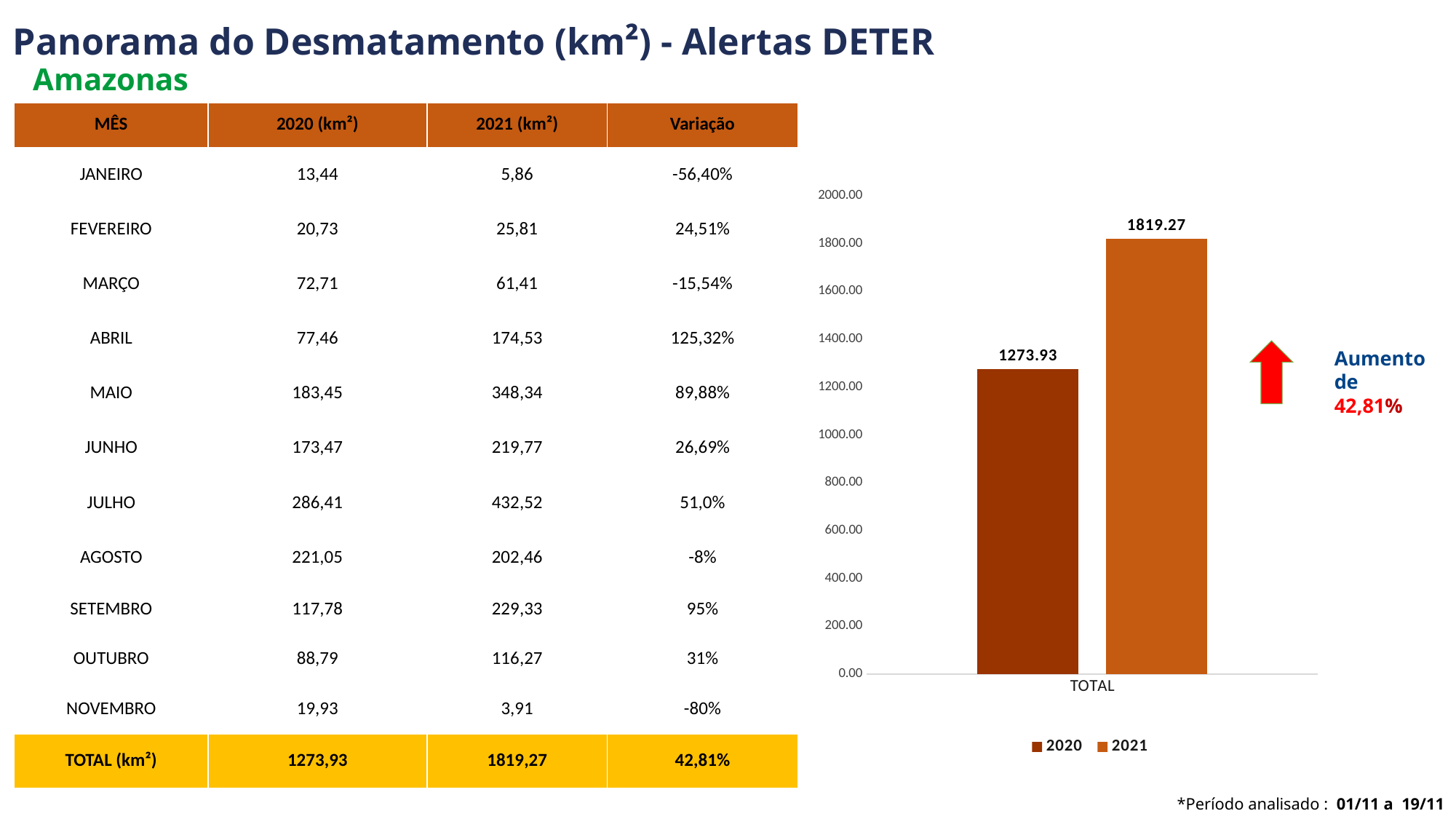
In the chart, what is the value of the 2021 bar for TOTAL? 1819.27 What kind of chart is shown on the slide? bar chart How many series does the chart legend list? 2 What percentage increase is annotated next to the red arrow beside the chart? 42,81% In the chart, which series has the lowest TOTAL value? 2020 In the chart, what is the value of the 2020 bar for TOTAL? 1273.93 In the chart, is the 2021 TOTAL bar greater or less than 1600.00? greater In the chart, what is the difference between the 2021 and 2020 TOTAL values? 545.34 What is the label of the category on the x axis of the chart? TOTAL In the chart, which series has the higher TOTAL bar, 2020 or 2021? 2021 How many categories are shown on the x axis of the chart? 1 In the chart, is the 2020 TOTAL bar greater or less than 1400.00? less